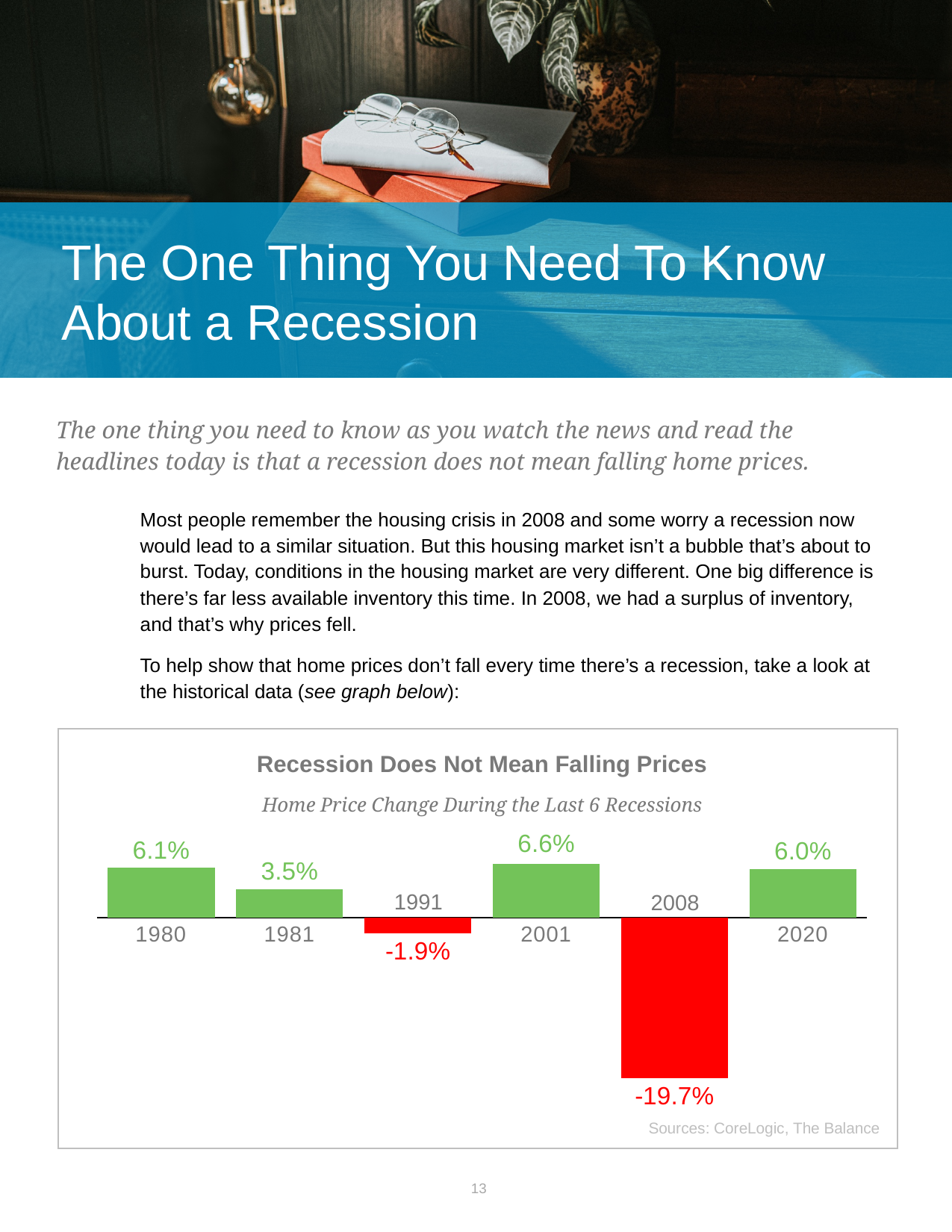
How many recessions are shown in the chart? 6 What is the difference between the home price change in 2001 and in 1981? 3.1% What type of chart is shown on the slide? Bar chart What is the title of the chart? Recession Does Not Mean Falling Prices Which recession year shows the highest home price change? 2001 What was the home price change during the 1980 recession? 6.1% Which had a larger home price change, 1980 or 1981? 1980 What was the home price change during the 2020 recession? 6.0% What was the home price change during the 1991 recession? -1.9% What was the home price change during the 2008 recession? -19.7% How many of the recessions shown had a negative home price change? 2 Which recession year shows the lowest home price change? 2008